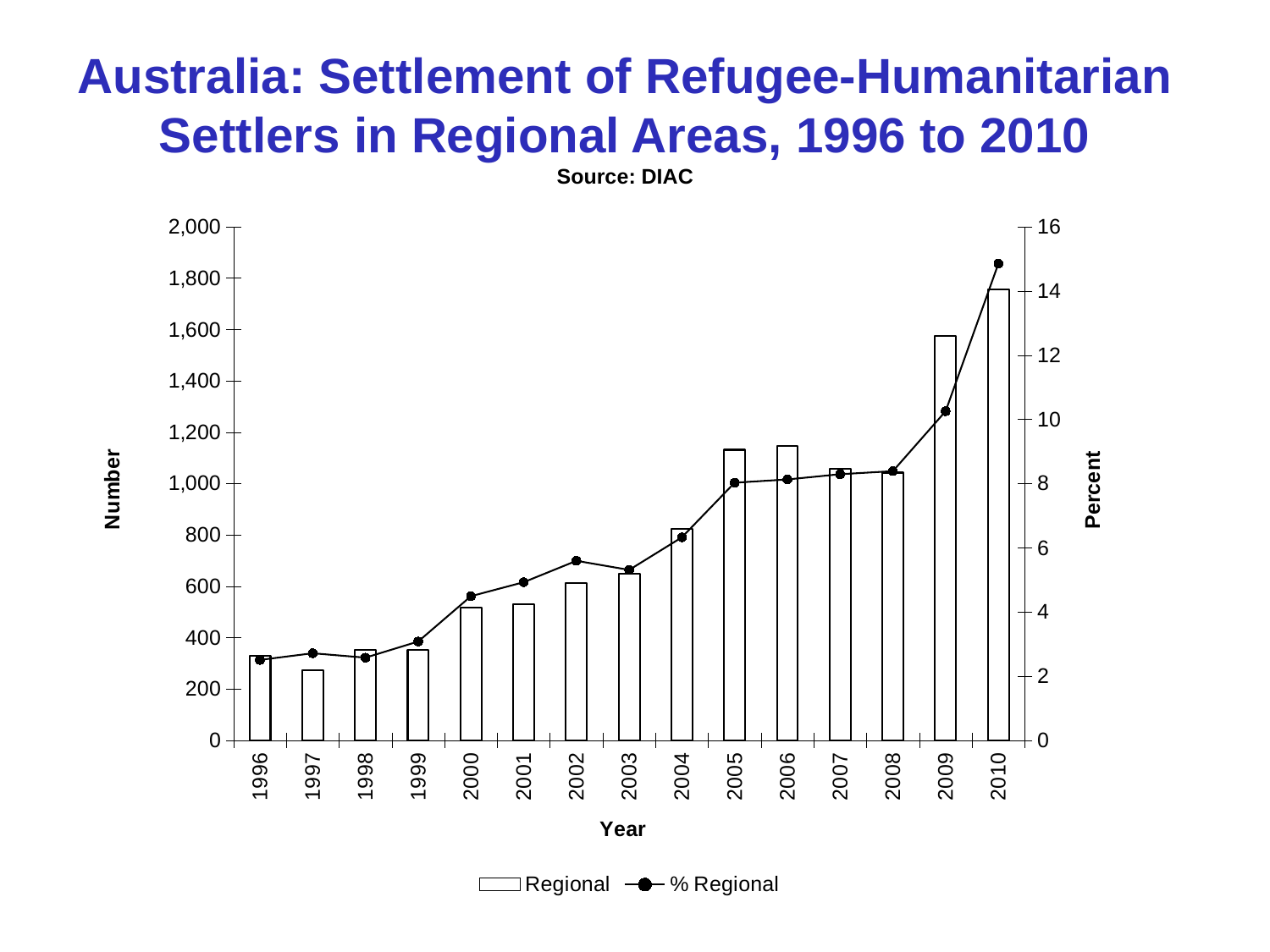
Is the Regional value for 1997 greater or less than 400? less Is the Regional value for 2010 greater or less than 1,600? greater Which year has the highest Regional bar? 2010 How many series does the legend list? 2 Which year has the larger Regional bar, 2004 or 2003? 2004 Which year has the lowest Regional bar? 1997 How many years are plotted along the x axis? 15 Which year has the highest % Regional value? 2010 What kind of chart is shown on the slide? A combined bar and line chart Overall, does the % Regional line rise or fall from 1996 to 2010? rise Is the % Regional value for 1996 greater or less than 4? less